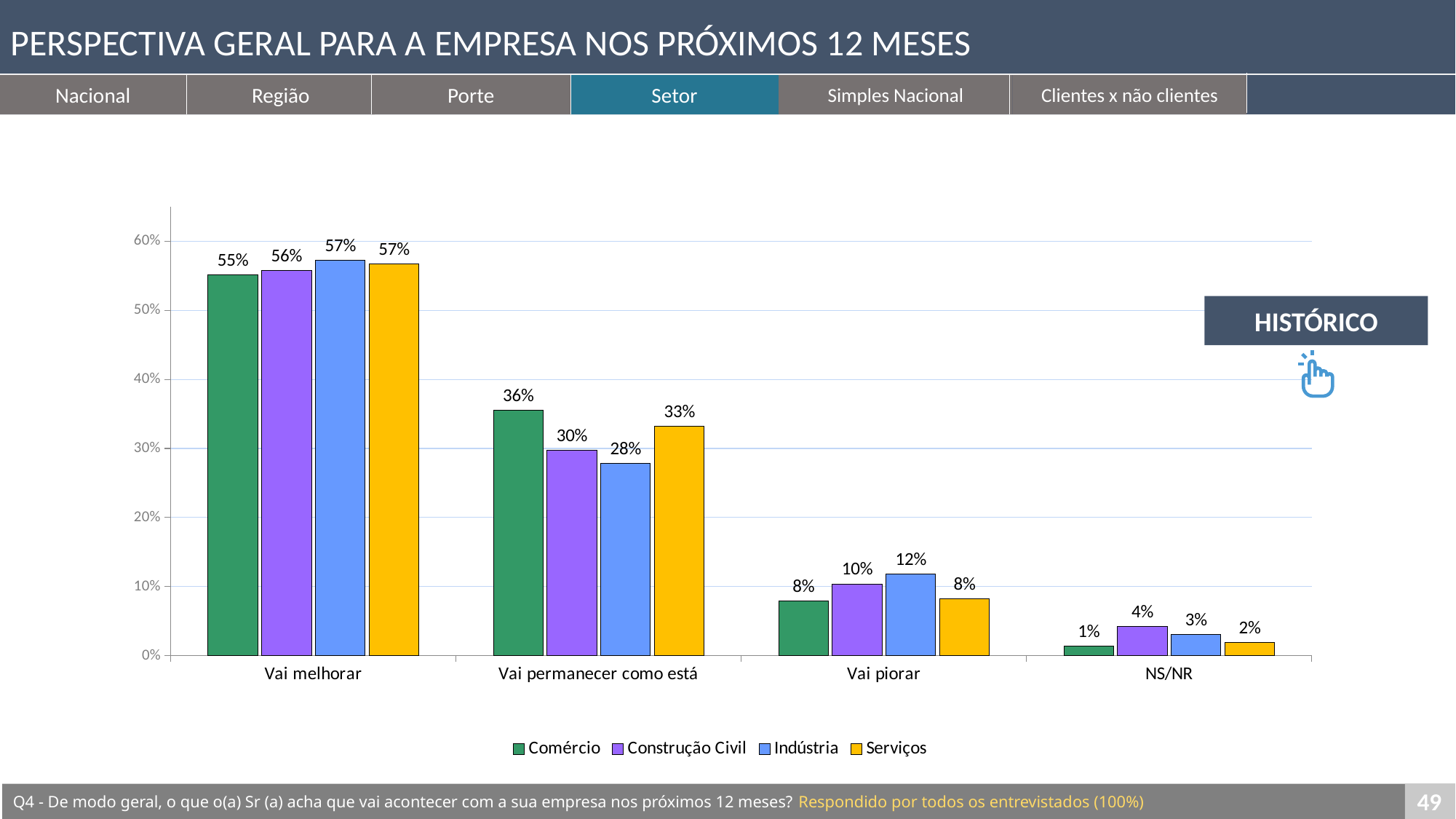
Which colour represents Serviços in the chart? Yellow What is the difference between Comércio and Indústria in the 'Vai permanecer como está' category? 8% What is the value for Serviços in the 'Vai permanecer como está' category? 33% How many series does the legend list? 4 What is the value for Construção Civil in the 'NS/NR' category? 4% How many categories are shown on the x axis? 4 What is the value for Indústria in the 'Vai piorar' category? 12% What kind of chart is shown on the slide? Bar chart Which series has the lowest value in the 'NS/NR' category? Comércio What is the value for Comércio in the 'Vai melhorar' category? 55% Which is larger in the 'Vai piorar' category: Construção Civil or Serviços? Construção Civil Which series has the highest value in the 'Vai permanecer como está' category? Comércio